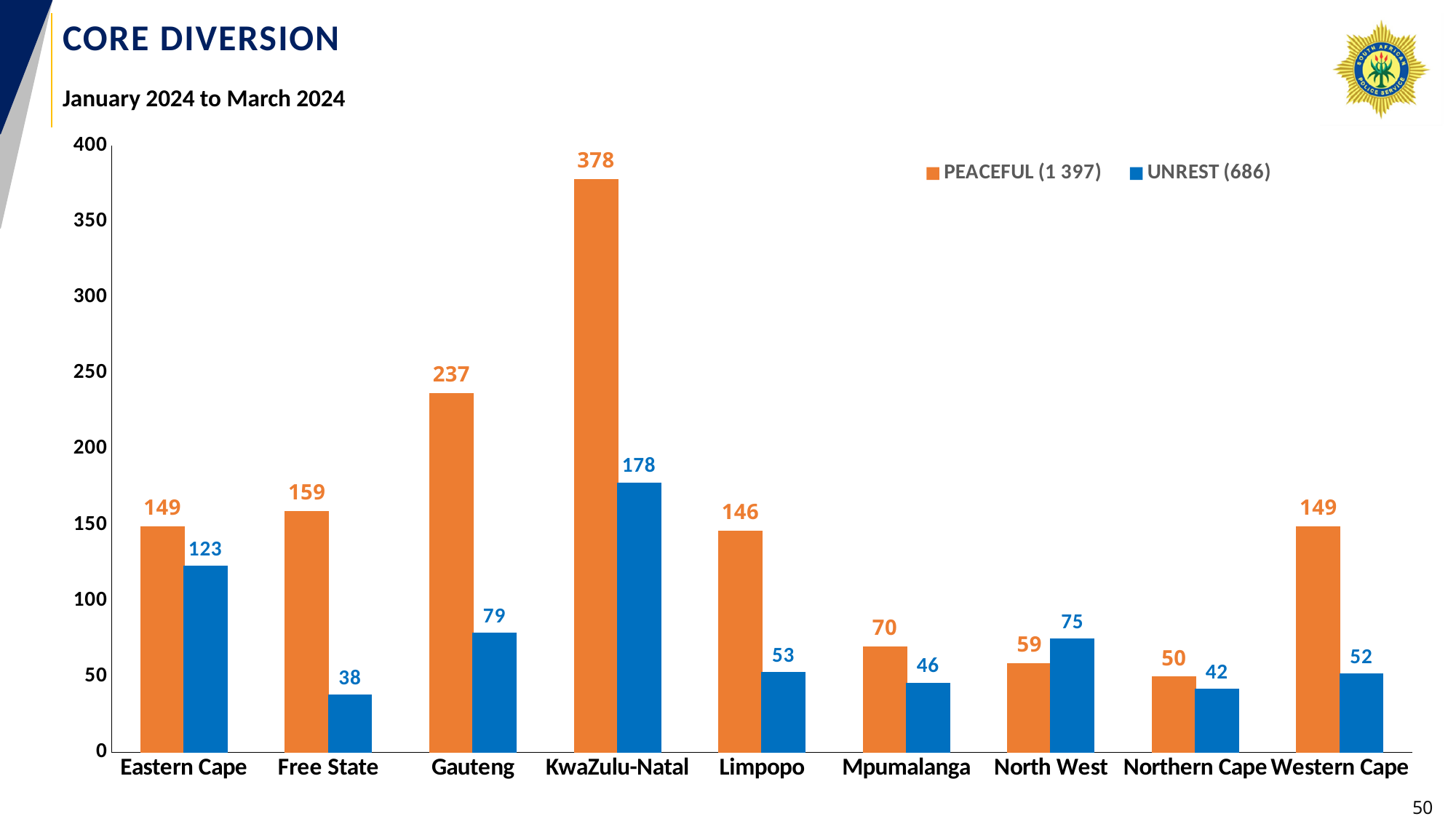
How many series does the legend list? 2 What is the difference between the PEACEFUL and UNREST values for Gauteng? 158 Which province has the lowest PEACEFUL value? Northern Cape Which is larger for North West, the PEACEFUL value or the UNREST value? UNREST Is the PEACEFUL value for Free State greater or less than 150? greater Which province has the highest UNREST value? KwaZulu-Natal What is the UNREST value for Eastern Cape? 123 How many provinces are shown on the x axis? 9 What is the PEACEFUL value for KwaZulu-Natal? 378 What is the PEACEFUL value for Northern Cape? 50 What total is shown in the legend for the UNREST series? 686 What kind of chart is shown on the slide? Bar chart